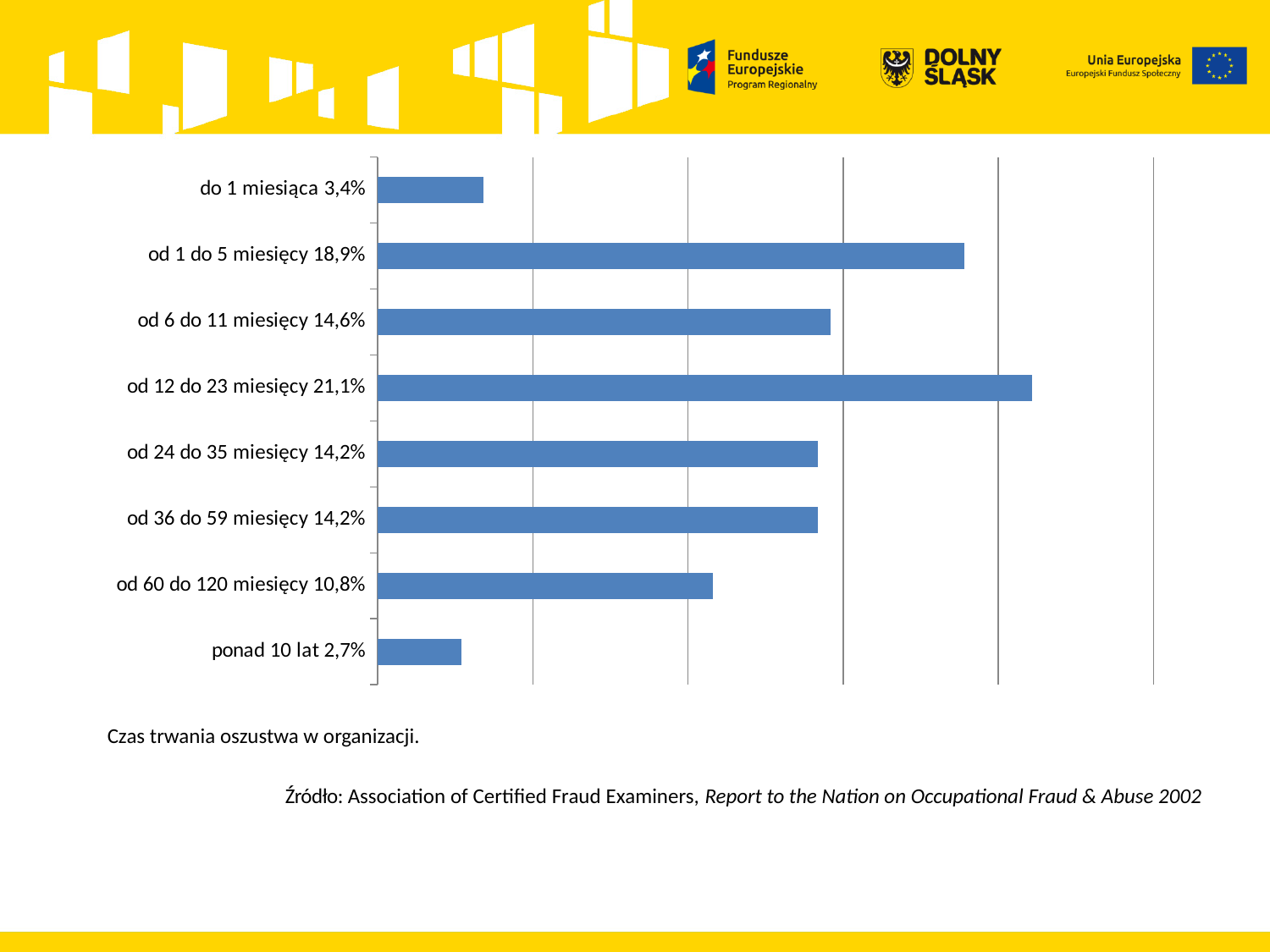
What is the value for "do 1 miesiąca"? 3,4% What is the value for "ponad 10 lat"? 2,7% What is the value for "od 60 do 120 miesięcy"? 10,8% Which is larger: the value for "od 1 do 5 miesięcy" or for "od 6 do 11 miesięcy"? od 1 do 5 miesięcy Which category has the highest value? od 12 do 23 miesięcy What is the value for "od 12 do 23 miesięcy"? 21,1% What kind of chart is shown on the slide? bar chart How many categories (bars) does the chart show? 8 What is the difference between the values for "od 12 do 23 miesięcy" and "od 1 do 5 miesięcy"? 2,2% Which category has the lowest value? ponad 10 lat What caption is written below the chart describing what it shows? Czas trwania oszustwa w organizacji. What is the difference between the values for "od 60 do 120 miesięcy" and "ponad 10 lat"? 8,1%